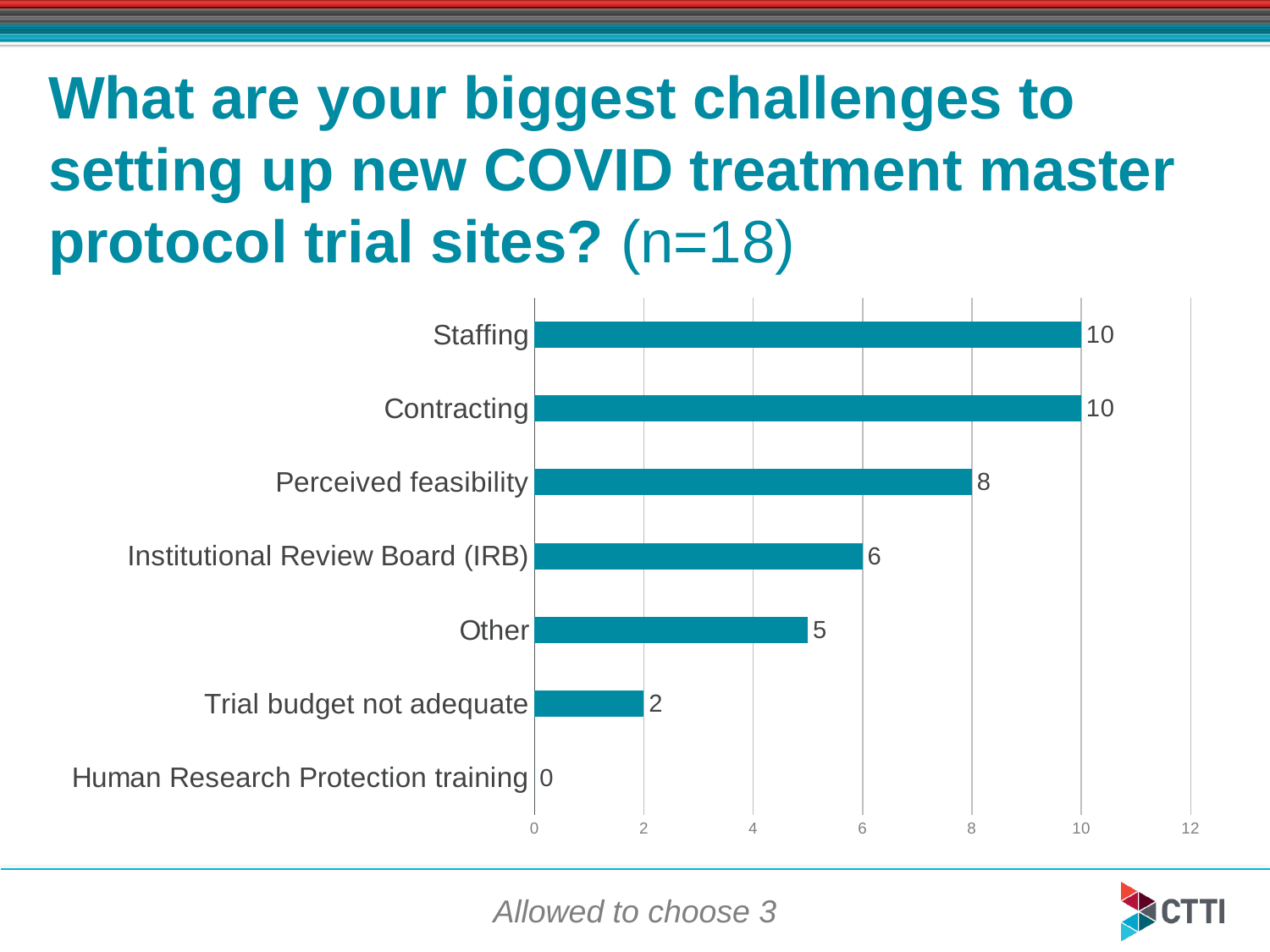
Which is larger, the value for Perceived feasibility or the value for Institutional Review Board (IRB)? Perceived feasibility What is the sample size (n) stated in the slide title? 18 Which two categories share the highest value? Staffing and Contracting What is the value for Human Research Protection training? 0 How many categories are shown in the chart? 7 What kind of chart is shown on the slide? Bar chart What is the difference between the values for Staffing and Other? 5 What is the value for Institutional Review Board (IRB)? 6 What is the value for Perceived feasibility? 8 Which category has the lowest value? Human Research Protection training What is the maximum value shown on the x axis? 12 What is the value for Trial budget not adequate? 2